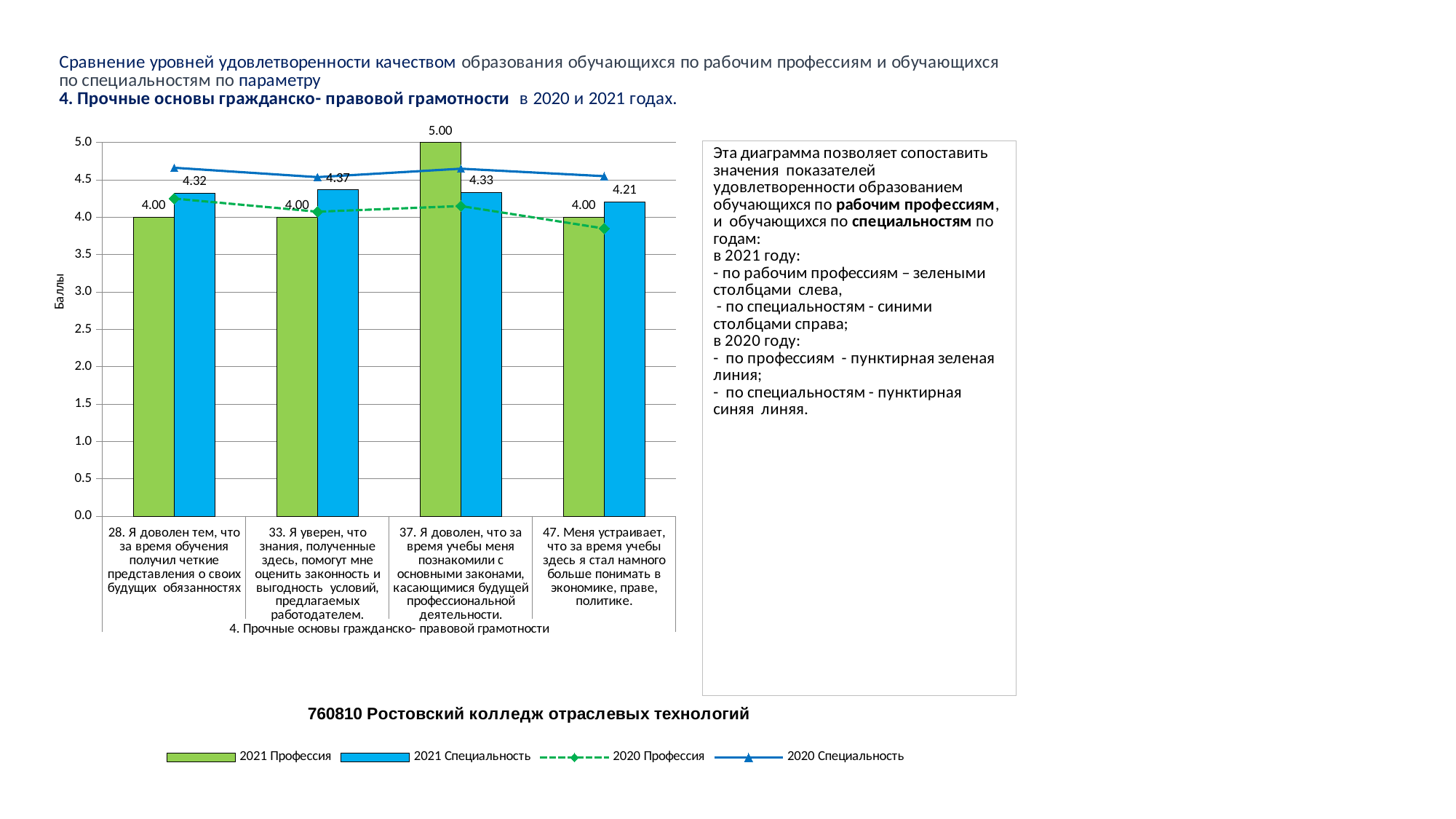
What is the value of the 2021 Специальность bar for question 47 (Меня устраивает, что за время учебы здесь я стал намного больше понимать в экономике, праве, политике)? 4.21 What is the value of the 2021 Профессия bar for question 37 (Я доволен, что за время учебы меня познакомили с основными законами...)? 5.00 What is the difference between the 2021 Профессия and 2021 Специальность bars for question 37? 0.67 How many categories (questions) are shown on the x axis? 4 What is the label of the vertical axis? Баллы Is the 2020 Специальность line value for question 28 greater or less than 4.5? greater Which category has the lowest 2021 Специальность bar? 47. Меня устраивает, что за время учебы здесь я стал намного больше понимать в экономике, праве, политике. Is the 2020 Профессия line value for question 47 greater or less than 4.0? less How many series does the legend list? 4 For question 28, which is larger: the 2021 Профессия bar or the 2021 Специальность bar? 2021 Специальность Which category has the highest 2021 Профессия bar? 37. Я доволен, что за время учебы меня познакомили с основными законами, касающимися будущей профессиональной деятельности. What is the value of the 2021 Специальность bar for question 33 (Я уверен, что знания, полученные здесь, помогут мне оценить законность...)? 4.37